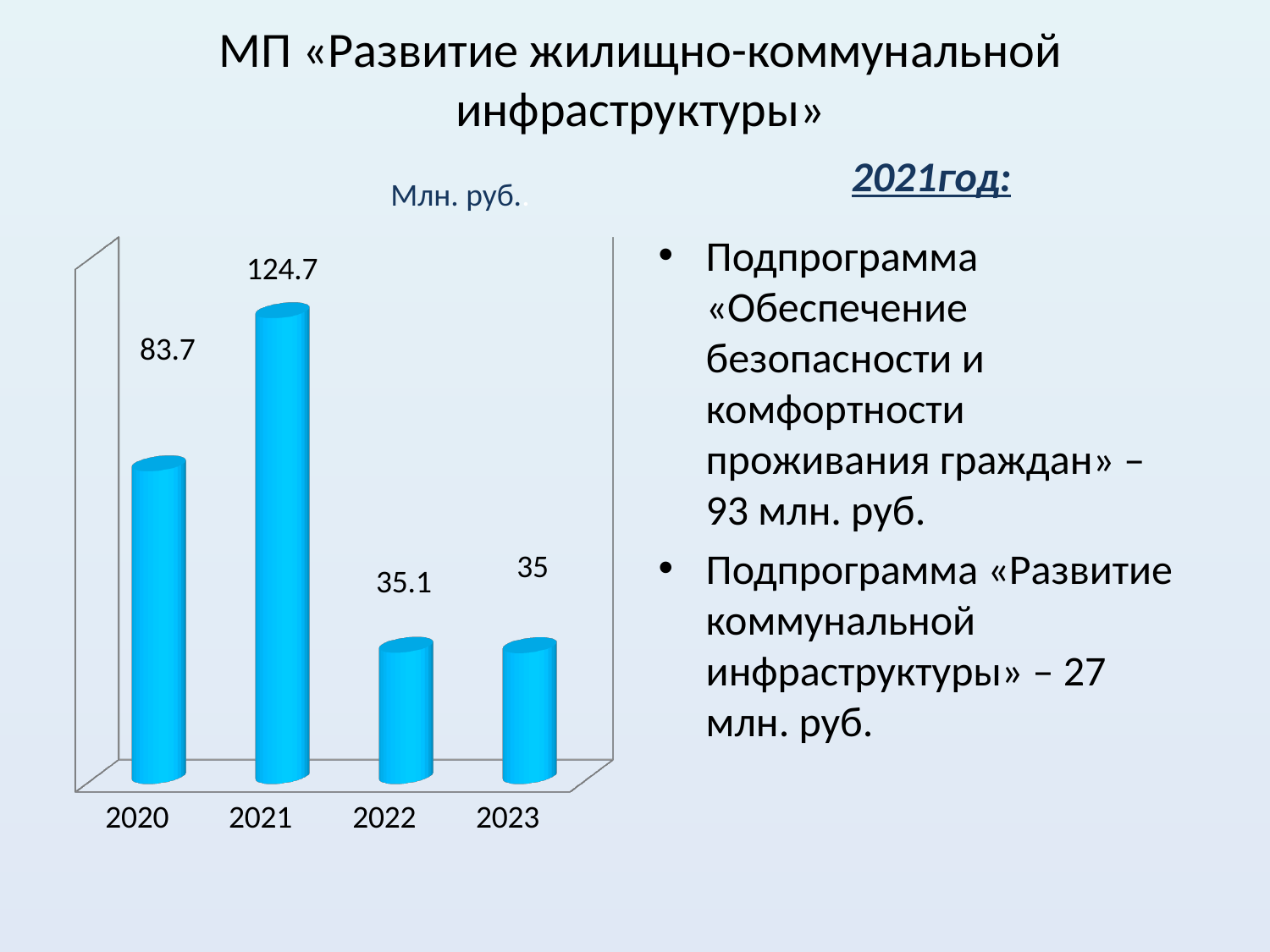
How many years are shown on the x axis of the chart? 4 What is the value for 2020 in the chart? 83.7 What is the value for 2022 in the chart? 35.1 What is the difference between the values for 2021 and 2020? 41 Which year has the highest value in the chart? 2021 Which is larger, the value for 2020 or the value for 2022? 2020 What is the value for 2021 in the chart? 124.7 What is the title of the chart? Млн. руб. What kind of chart is shown on the slide? bar chart What is the difference between the values for 2020 and 2023? 48.7 Do the values rise or fall from 2021 to 2023? fall What is the value for 2023 in the chart? 35